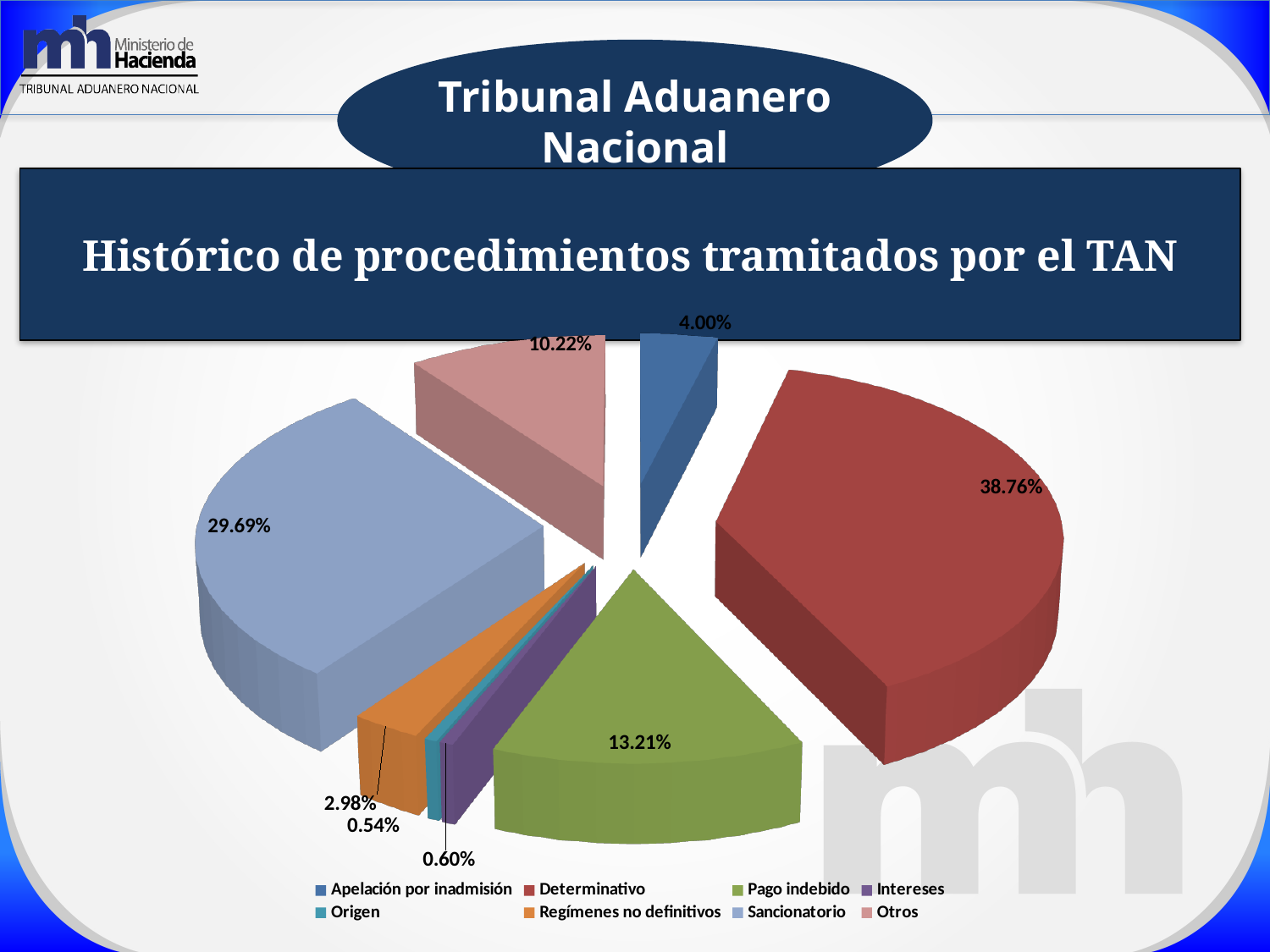
What percentage does the Otros slice represent? 10.22% What percentage does the Pago indebido slice represent? 13.21% What is the title of the chart? Histórico de procedimientos tramitados por el TAN What percentage does the Regímenes no definitivos slice represent? 2.98% What kind of chart is shown on the slide? pie chart What percentage does the Apelación por inadmisión slice represent? 4.00% What is the difference in percentage points between Determinativo and Sancionatorio? 9.07% How many categories does the pie chart show? 8 What percentage does the Sancionatorio slice represent? 29.69% Which category has the largest share of the pie? Determinativo Which is larger, the Pago indebido slice or the Otros slice? Pago indebido What percentage does the Determinativo slice represent? 38.76%